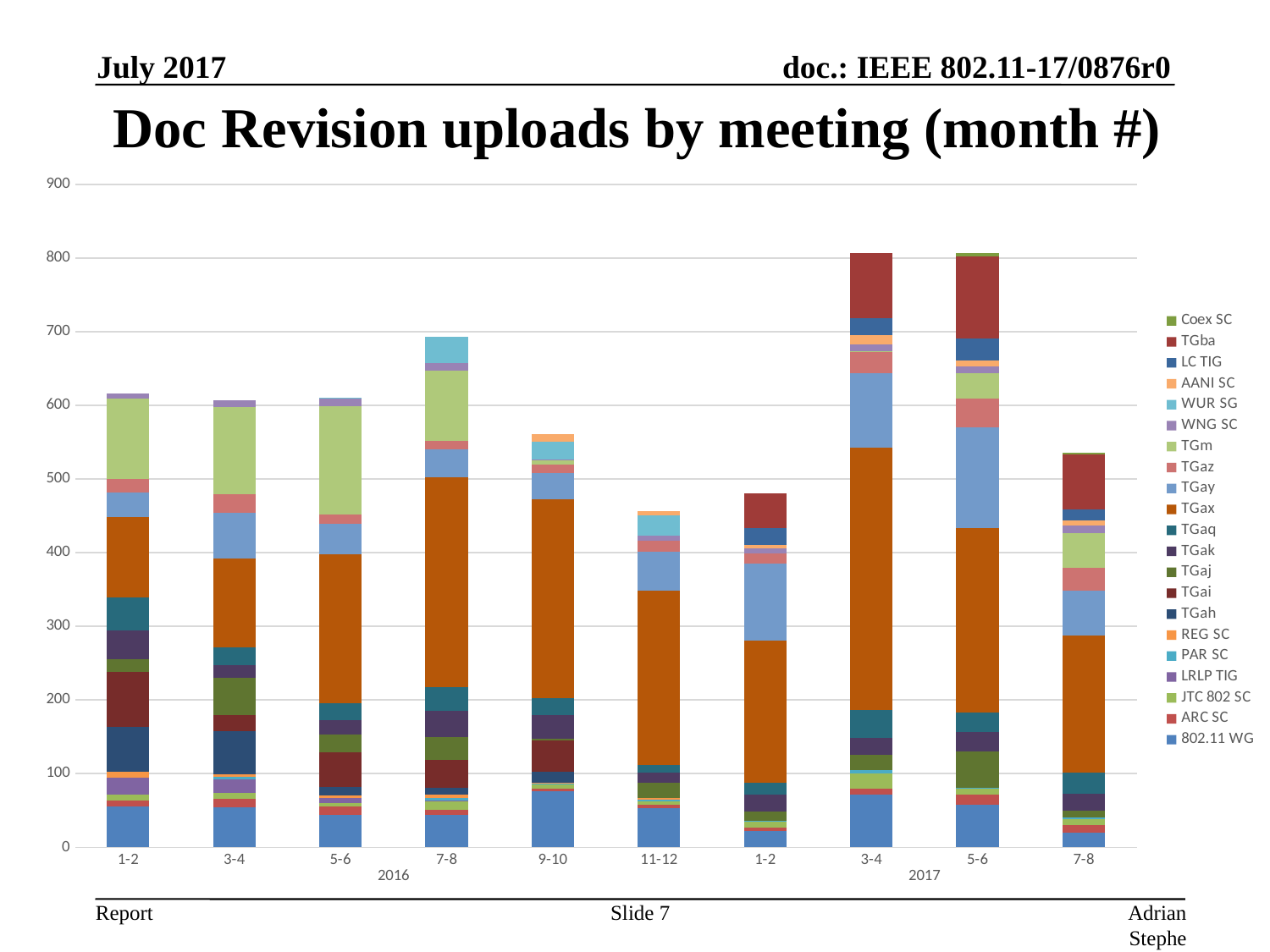
What is the title of the chart? Doc Revision uploads by meeting (month #) Is the total for the 7-8 2017 bar greater or less than 500? greater Which bar has a larger total, 3-4 2017 or 7-8 2017? 3-4 2017 Is the total for the 7-8 2016 bar greater or less than 600? greater Is the total for the 1-2 2016 bar greater or less than 600? greater Which series is listed last in the legend (at the bottom of each stacked bar)? 802.11 WG Which bar has a larger total, 7-8 2016 or 9-10 2016? 7-8 2016 How many bars (meetings) are plotted in the chart? 10 What kind of chart is shown on the slide? Stacked bar chart How many series does the legend list? 21